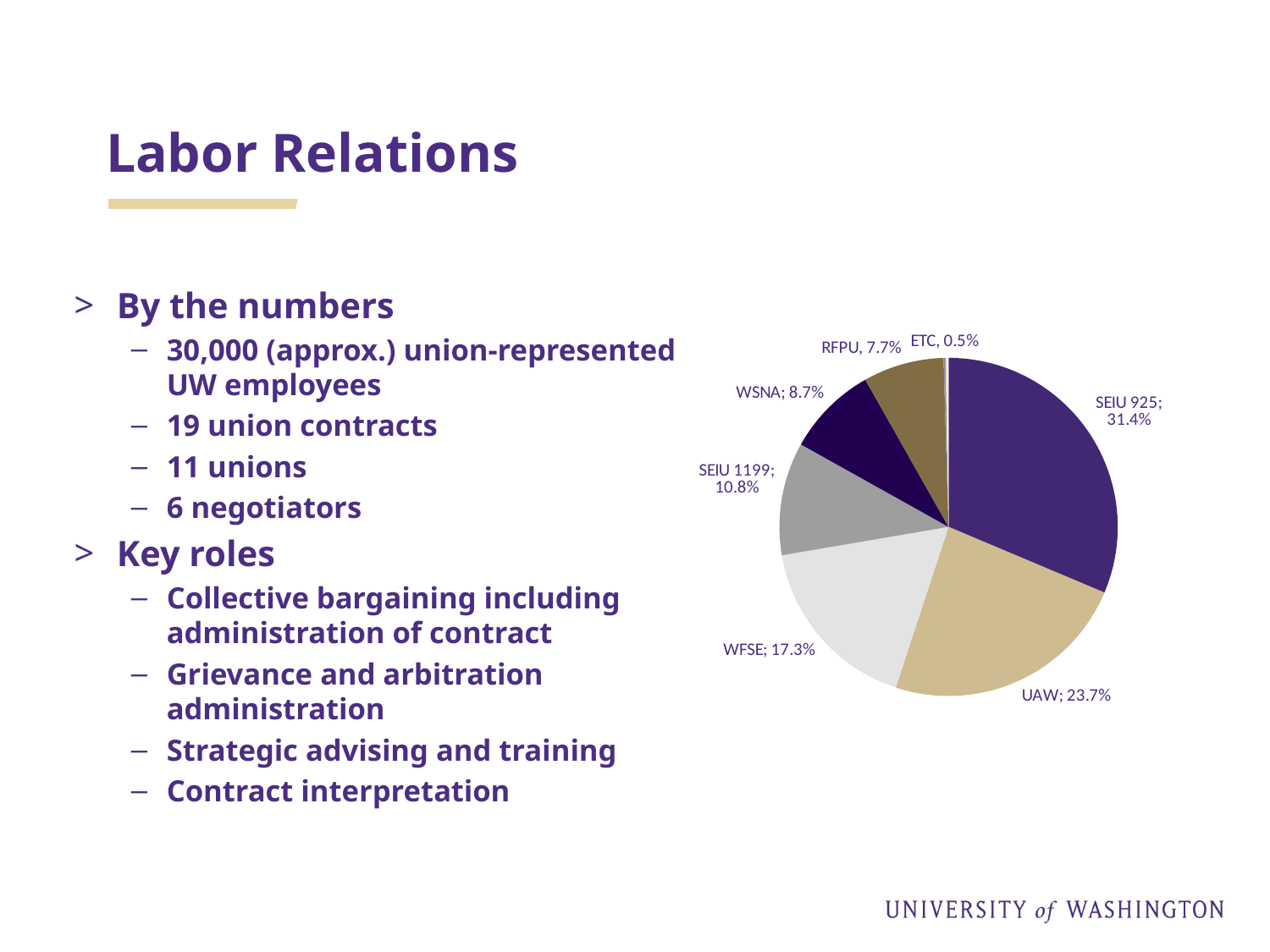
What share of the pie does WFSE represent? 17.3% What is the combined share of the WSNA and ETC slices? 9.2% Which slice of the pie is the largest? SEIU 925 What share of the pie does SEIU 1199 represent? 10.8% What share of the pie does UAW represent? 23.7% Which slice is larger, WSNA or RFPU? WSNA What share of the pie does SEIU 925 represent? 31.4% What is the difference in percentage points between the SEIU 925 and UAW slices? 7.7 Which slice of the pie is the smallest? ETC What kind of chart is shown on the slide? Pie chart What share of the pie does RFPU represent? 7.7%